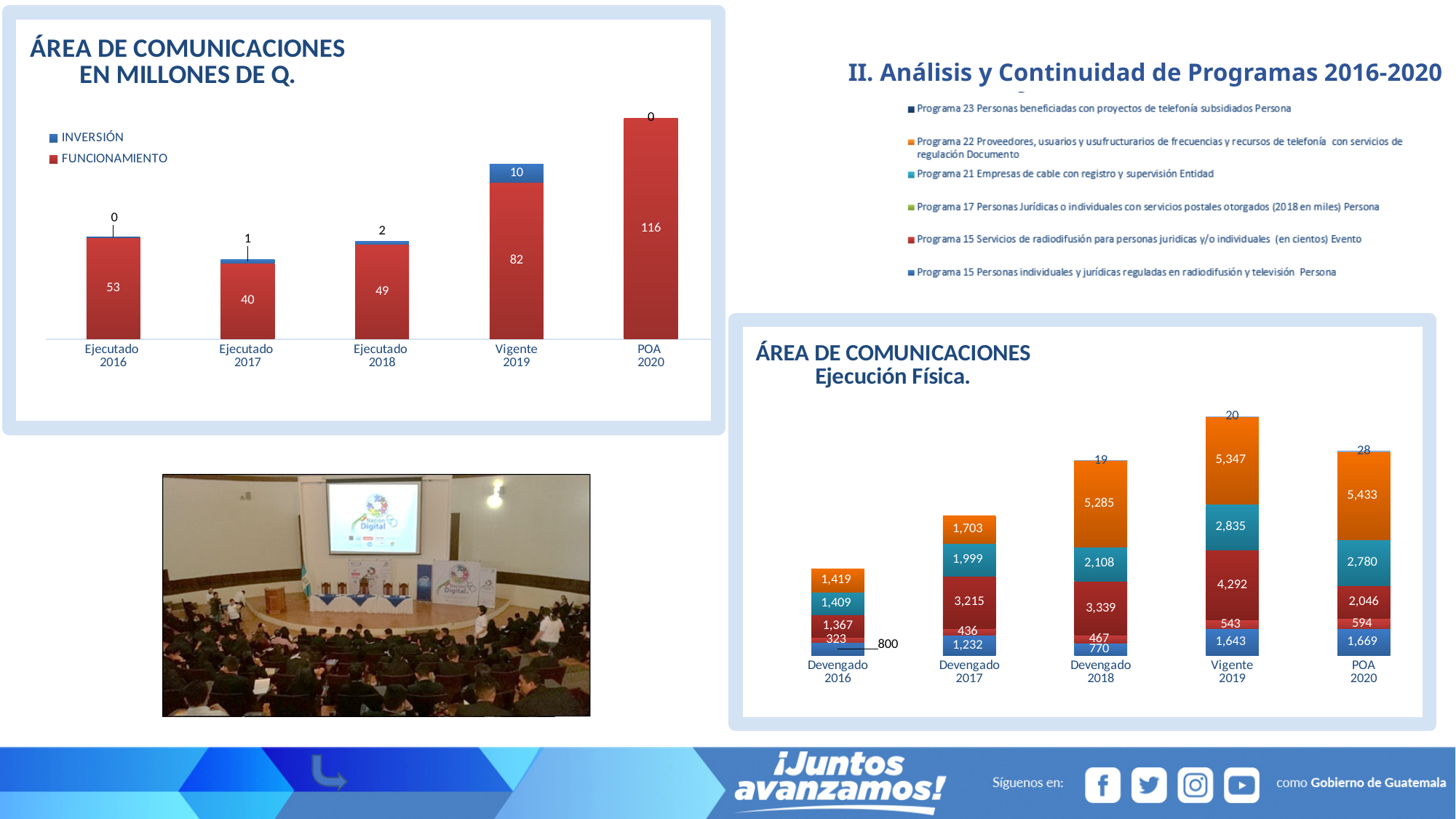
In the chart titled 'ÁREA DE COMUNICACIONES EN MILLONES DE Q.', which category has the lowest FUNCIONAMIENTO value? Ejecutado 2017 In the chart titled 'ÁREA DE COMUNICACIONES Ejecución Física.', what is the value of the bottom (blue) segment for Devengado 2017? 1,232 In the chart titled 'ÁREA DE COMUNICACIONES EN MILLONES DE Q.', how many series does the legend list? 2 What kind of chart is the 'ÁREA DE COMUNICACIONES Ejecución Física.' chart? Stacked bar chart In the chart titled 'ÁREA DE COMUNICACIONES EN MILLONES DE Q.', how many categories are shown on the x axis? 5 In the chart titled 'ÁREA DE COMUNICACIONES EN MILLONES DE Q.', what is the INVERSIÓN value for Vigente 2019? 10 In the chart titled 'ÁREA DE COMUNICACIONES Ejecución Física.', what is the value of the orange segment for POA 2020? 5,433 In the chart titled 'ÁREA DE COMUNICACIONES EN MILLONES DE Q.', what is the difference between the FUNCIONAMIENTO values for POA 2020 and Vigente 2019? 34 In the chart titled 'ÁREA DE COMUNICACIONES Ejecución Física.', which category has the largest orange segment? POA 2020 In the chart titled 'ÁREA DE COMUNICACIONES EN MILLONES DE Q.', what is the total of the Vigente 2019 bar? 92 In the chart titled 'ÁREA DE COMUNICACIONES EN MILLONES DE Q.', what is the FUNCIONAMIENTO value for POA 2020? 116